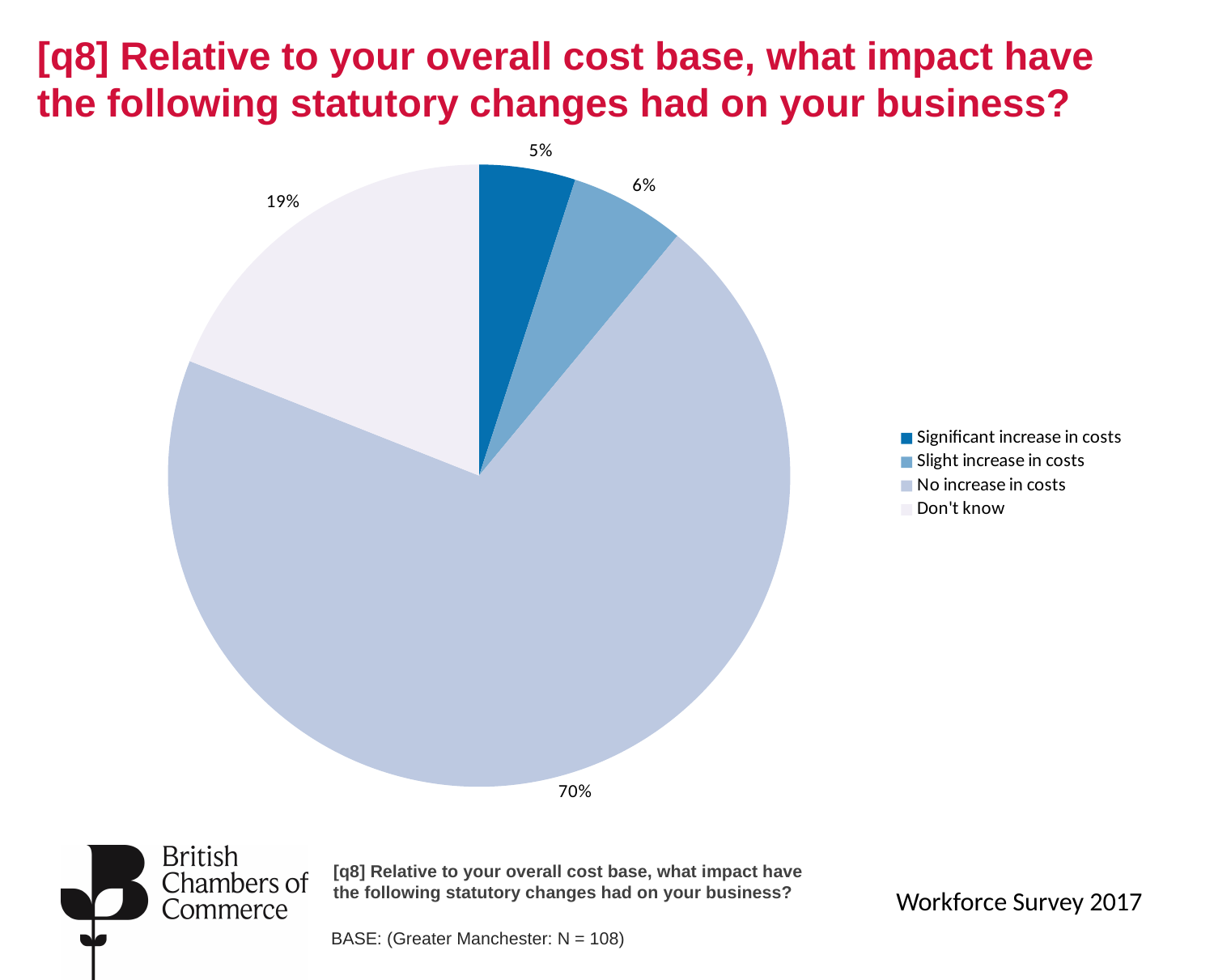
What share of respondents answered 'Don't know'? 19% Which category has the smallest slice of the pie? Significant increase in costs What is the difference between the 'No increase in costs' share and the 'Don't know' share? 51 percentage points Which is larger: the share for 'Slight increase in costs' or 'Significant increase in costs'? Slight increase in costs What is the base (sample size) stated for this chart? Greater Manchester: N = 108 Which category has the largest slice of the pie? No increase in costs How many categories does the legend list? 4 What is the combined share of respondents reporting either a significant or a slight increase in costs? 11% What kind of chart is shown on the slide? pie chart What share of respondents reported a slight increase in costs? 6% What share of respondents reported no increase in costs? 70% What share of respondents reported a significant increase in costs? 5%